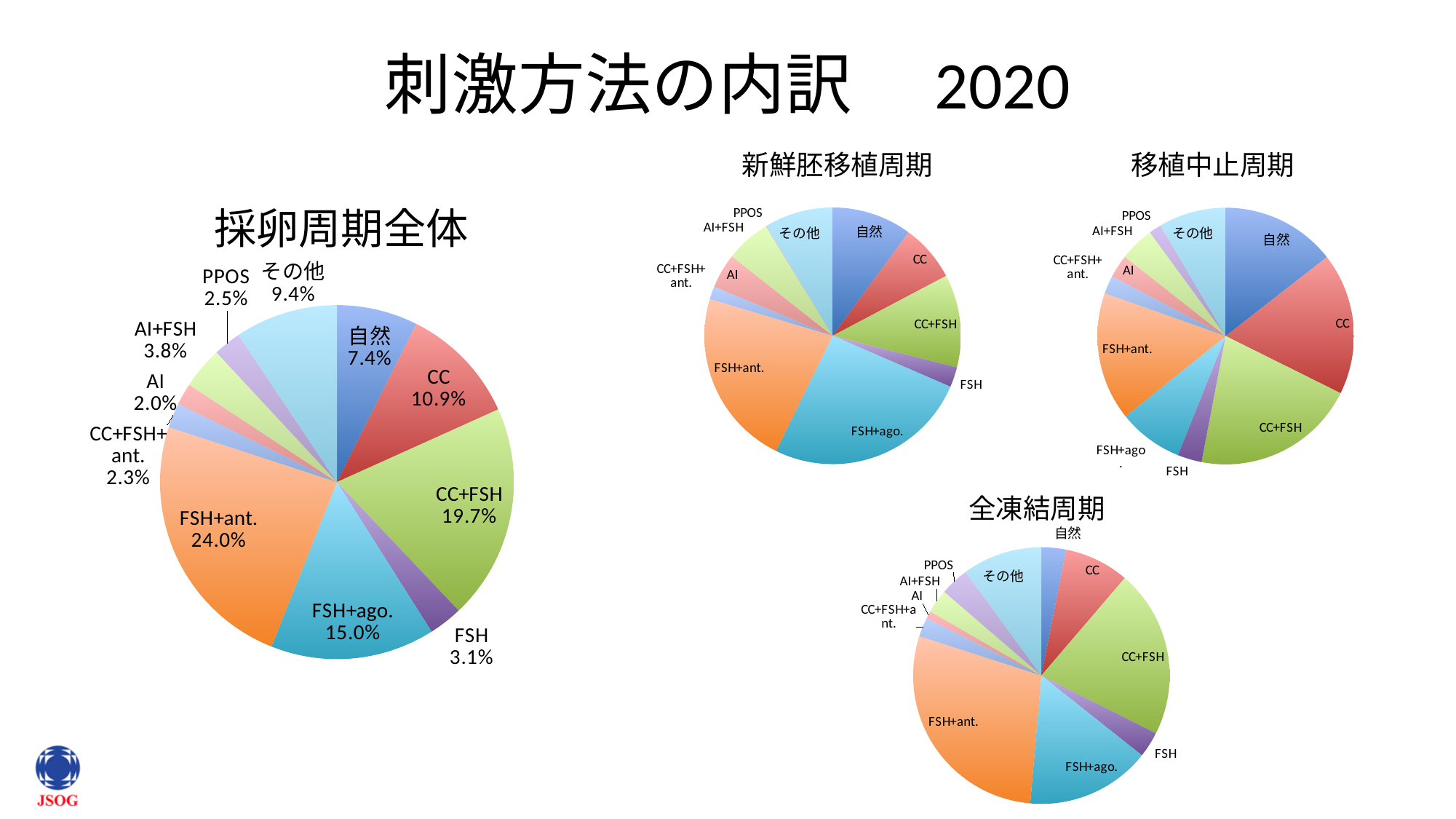
How many categories are shown in the 採卵周期全体 chart? 11 In the 採卵周期全体 chart, what percentage is shown for 自然? 7.4% In the 採卵周期全体 chart, which category has the largest share? FSH+ant. In the 採卵周期全体 chart, what percentage is shown for FSH+ant.? 24.0% In the 新鮮胚移植周期 chart, which is larger, FSH+ago. or CC? FSH+ago. In the 採卵周期全体 chart, what percentage is shown for AI? 2.0% In the 採卵周期全体 chart, what is the difference between the shares of FSH+ant. and FSH+ago.? 9.0% In the 採卵周期全体 chart, which is larger, CC or その他? CC What kind of chart is the 採卵周期全体 chart? Pie chart In the 採卵周期全体 chart, what percentage is shown for CC+FSH? 19.7% In the 採卵周期全体 chart, which category has the smallest share? AI In the 全凍結周期 chart, which category has the largest share? FSH+ant.